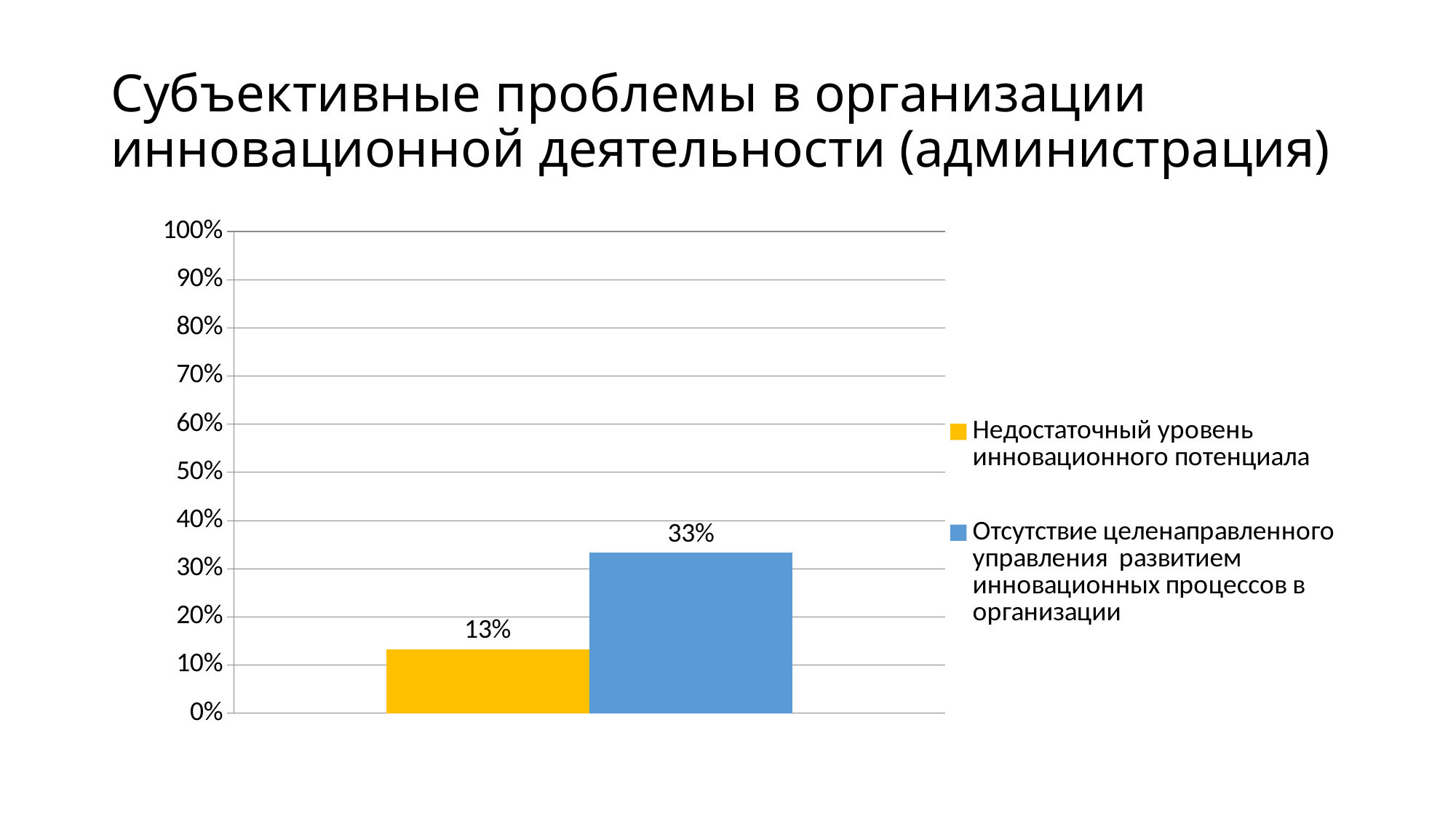
Which is larger: the value for "Недостаточный уровень инновационного потенциала" or the value for "Отсутствие целенаправленного управления развитием инновационных процессов в организации"? Отсутствие целенаправленного управления развитием инновационных процессов в организации What is the value for "Отсутствие целенаправленного управления развитием инновационных процессов в организации"? 33% What is the value for "Недостаточный уровень инновационного потенциала"? 13% Is the value for "Недостаточный уровень инновационного потенциала" greater or less than 20%? less What kind of chart is shown on the slide? Bar chart How many bars are plotted on the chart? 2 Which series has the lowest value? Недостаточный уровень инновационного потенциала How many series does the legend list? 2 Which series has the highest value? Отсутствие целенаправленного управления развитием инновационных процессов в организации What colour is the bar for "Недостаточный уровень инновационного потенциала"? Yellow What is the difference between the values for "Отсутствие целенаправленного управления развитием инновационных процессов в организации" and "Недостаточный уровень инновационного потенциала"? 20% Is the value for "Отсутствие целенаправленного управления развитием инновационных процессов в организации" greater or less than 30%? greater